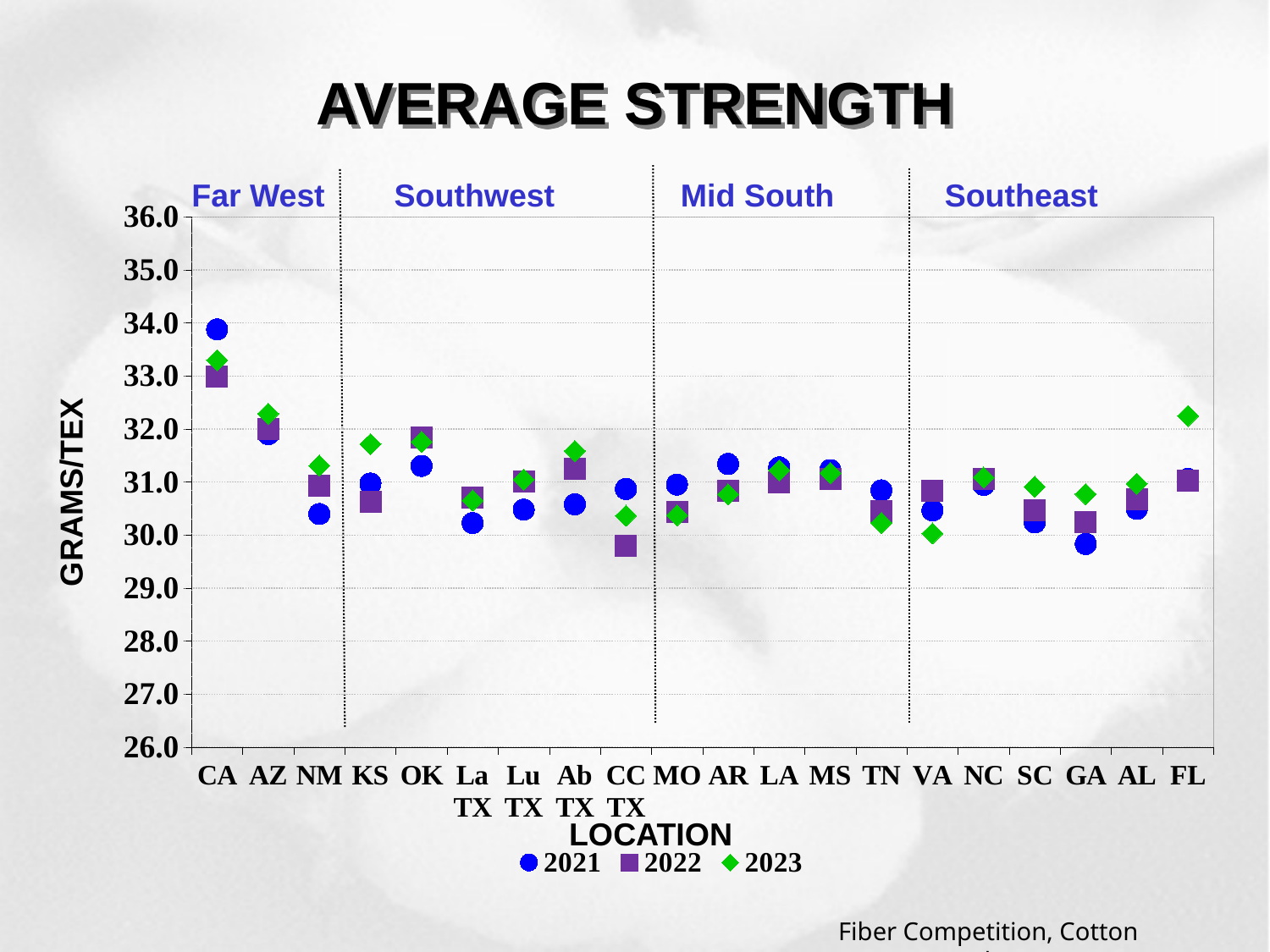
How many locations are plotted along the x axis? 20 Is the 2021 value for NM greater or less than 31.0? less Which location has the highest 2023 value? CA Which is larger at KS, the 2021 value or the 2023 value? 2023 How many series does the legend list? 3 Is the 2021 value for CA greater or less than 33.0? greater Which location has the highest 2021 value? CA What kind of chart is shown on the slide? Scatter (dot) chart Which location has the lowest 2022 value? CC TX Do the 2021 values rise or fall across the Far West locations from CA to NM? fall Is the 2023 value for KS greater or less than 31.0? greater What is the label on the y axis? GRAMS/TEX